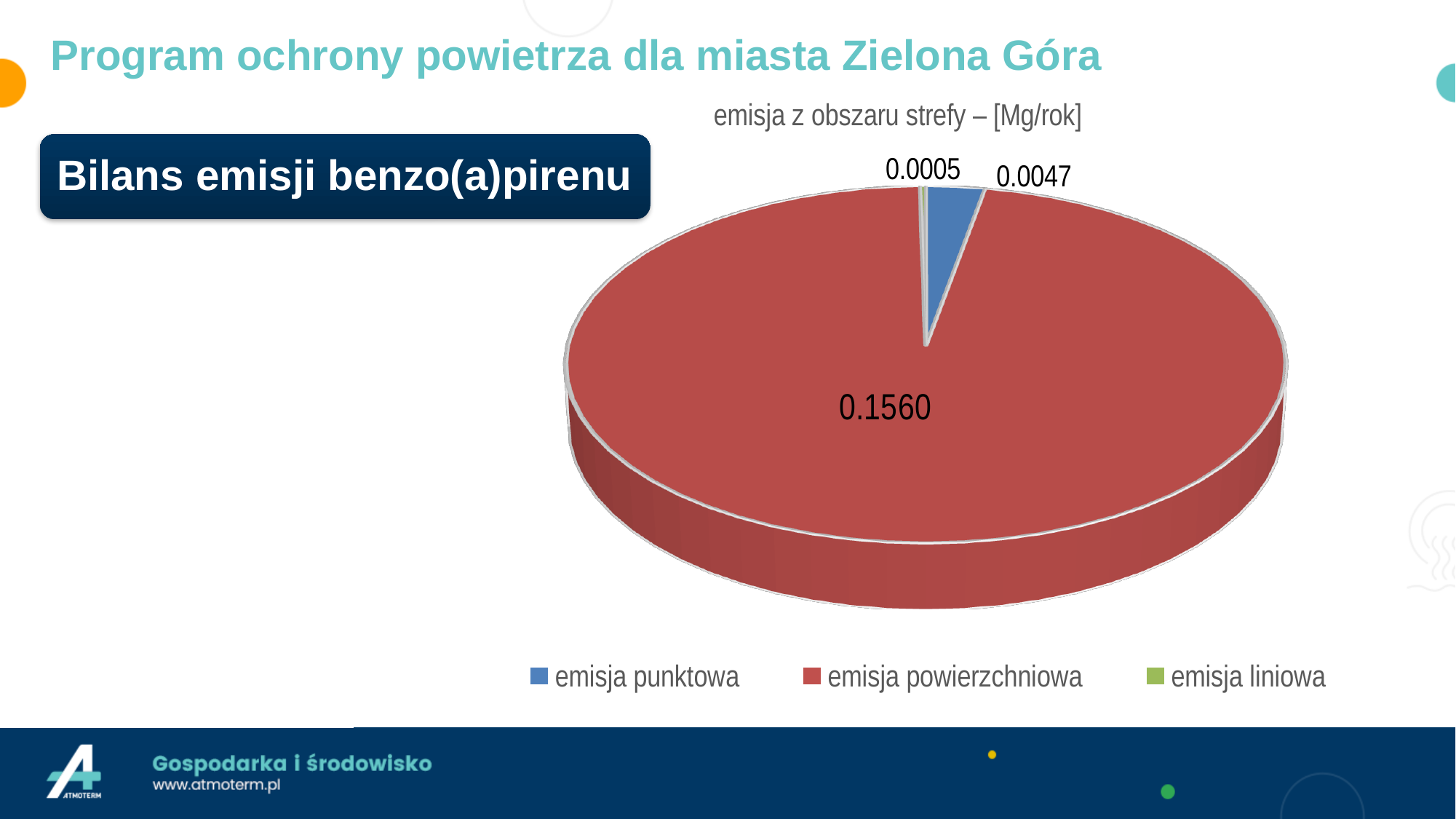
What colour is the slice for emisja powierzchniowa? red Which category has the largest slice of the pie? emisja powierzchniowa What is the value for emisja liniowa? 0.0005 What is the value for emisja powierzchniowa? 0.1560 What is the title of the pie chart? emisja z obszaru strefy – [Mg/rok] What is the value for emisja punktowa? 0.0047 Which is larger, emisja punktowa or emisja liniowa? emisja punktowa What is the difference between the values for emisja powierzchniowa and emisja punktowa? 0.1513 How many categories does the pie chart show? 3 What is the difference between the values for emisja punktowa and emisja liniowa? 0.0042 What type of chart is shown on the slide? pie chart Which category has the smallest slice of the pie? emisja liniowa